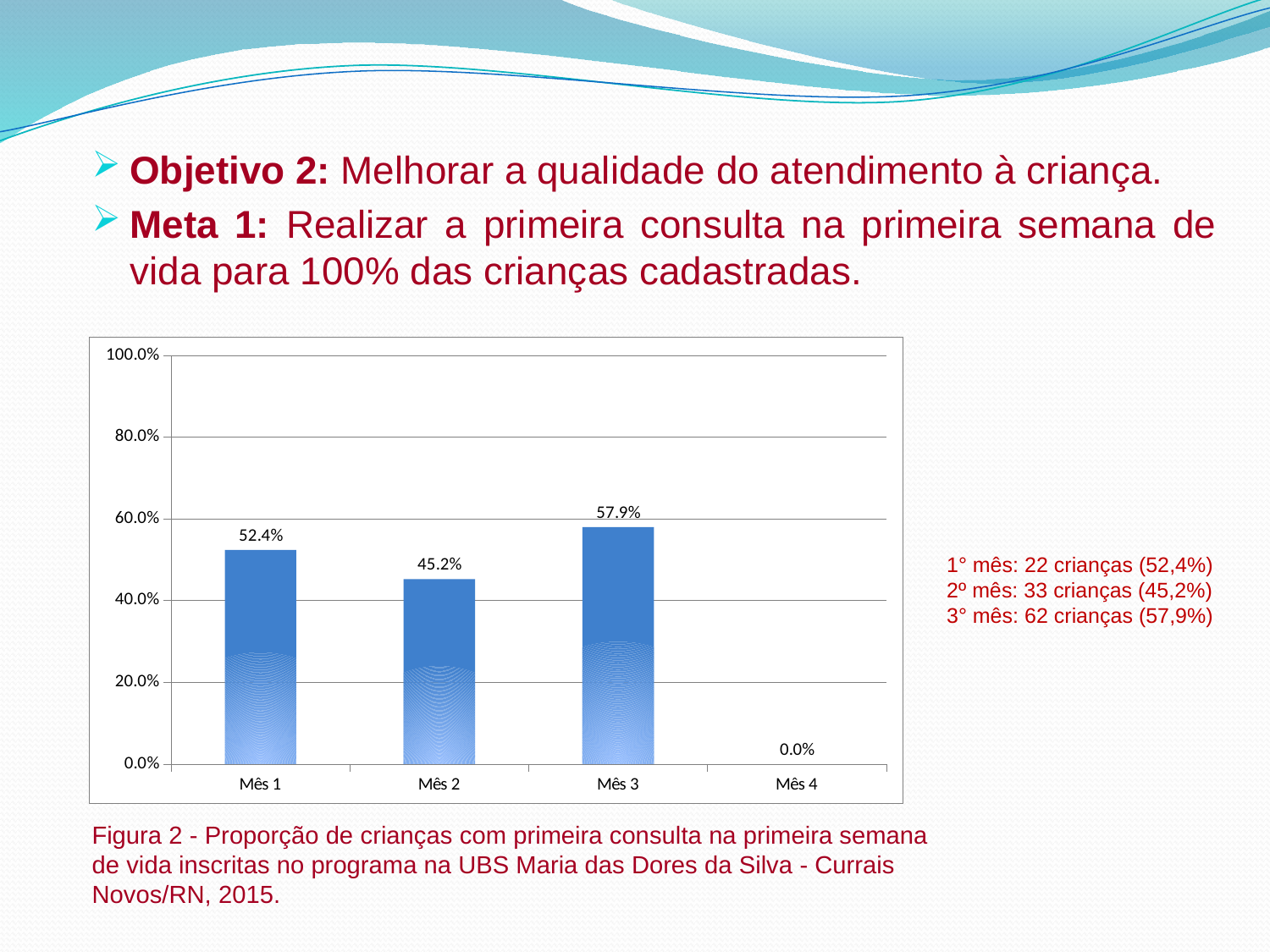
What is the highest tick value shown on the y axis? 100.0% How many months are shown on the x axis? 4 What is the value for Mês 2? 45.2% What is the value for Mês 3? 57.9% Which is larger, the value for Mês 1 or the value for Mês 2? Mês 1 Is the value for Mês 3 greater or less than 60.0%? less What is the difference between the values for Mês 3 and Mês 2? 12.7% What is the value for Mês 1? 52.4% Which month has the highest value? Mês 3 What is the value for Mês 4? 0.0% What kind of chart is shown on the slide? bar chart Which month has the lowest value? Mês 4